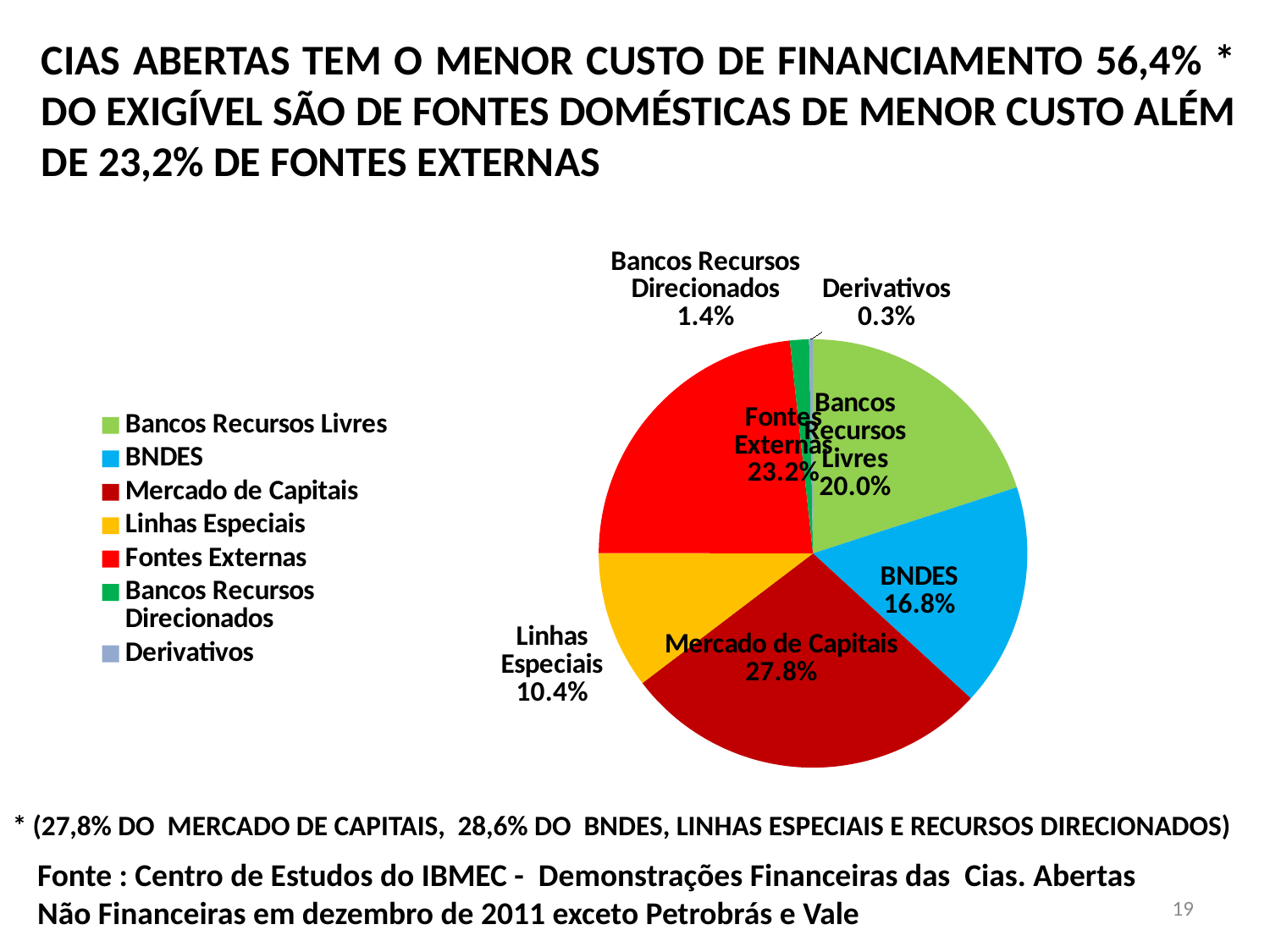
What colour is the Fontes Externas slice? red How many slices does the pie chart have? 7 What percentage is shown for Derivativos? 0.3% What is the difference between the shares of Fontes Externas and Bancos Recursos Livres? 3.2% What percentage is shown for Fontes Externas? 23.2% Which slice of the pie is the smallest? Derivativos What is the value for Linhas Especiais? 10.4% Which is larger, the share of BNDES or the share of Linhas Especiais? BNDES Which slice of the pie is the largest? Mercado de Capitais What kind of chart is shown on the slide? pie chart What share of the pie does Mercado de Capitais represent? 27.8% What is the value shown for BNDES? 16.8%